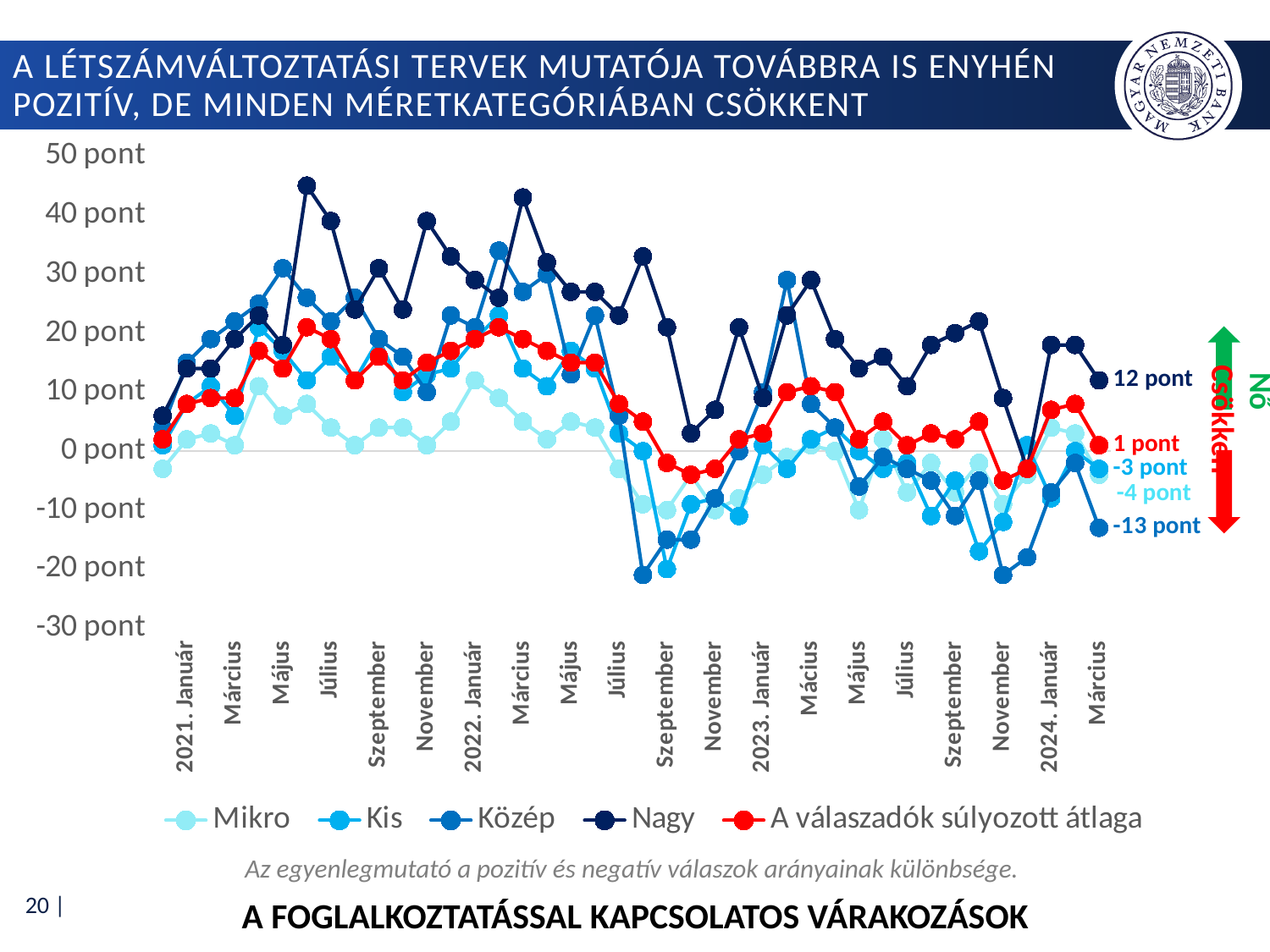
What is the difference between the final labelled values of Nagy and Közép? 25 pont Which series has the highest value at the last data point (March 2024)? Nagy Which series has the lowest value at the last data point (March 2024)? Közép Is the value for Nagy in May 2021 greater or less than 40 pont? less What is the final value labelled for the Mikro series? -4 pont At the last data point, which is larger: the Kis value or the Mikro value? Kis What kind of chart is shown on the slide? line chart Which series is drawn in red? A válaszadók súlyozott átlaga What is the final value labelled for 'A válaszadók súlyozott átlaga'? 1 pont What is the final (March 2024) value labelled for the Nagy series? 12 pont How many series does the legend list? 5 What is the final value labelled for the Közép series? -13 pont